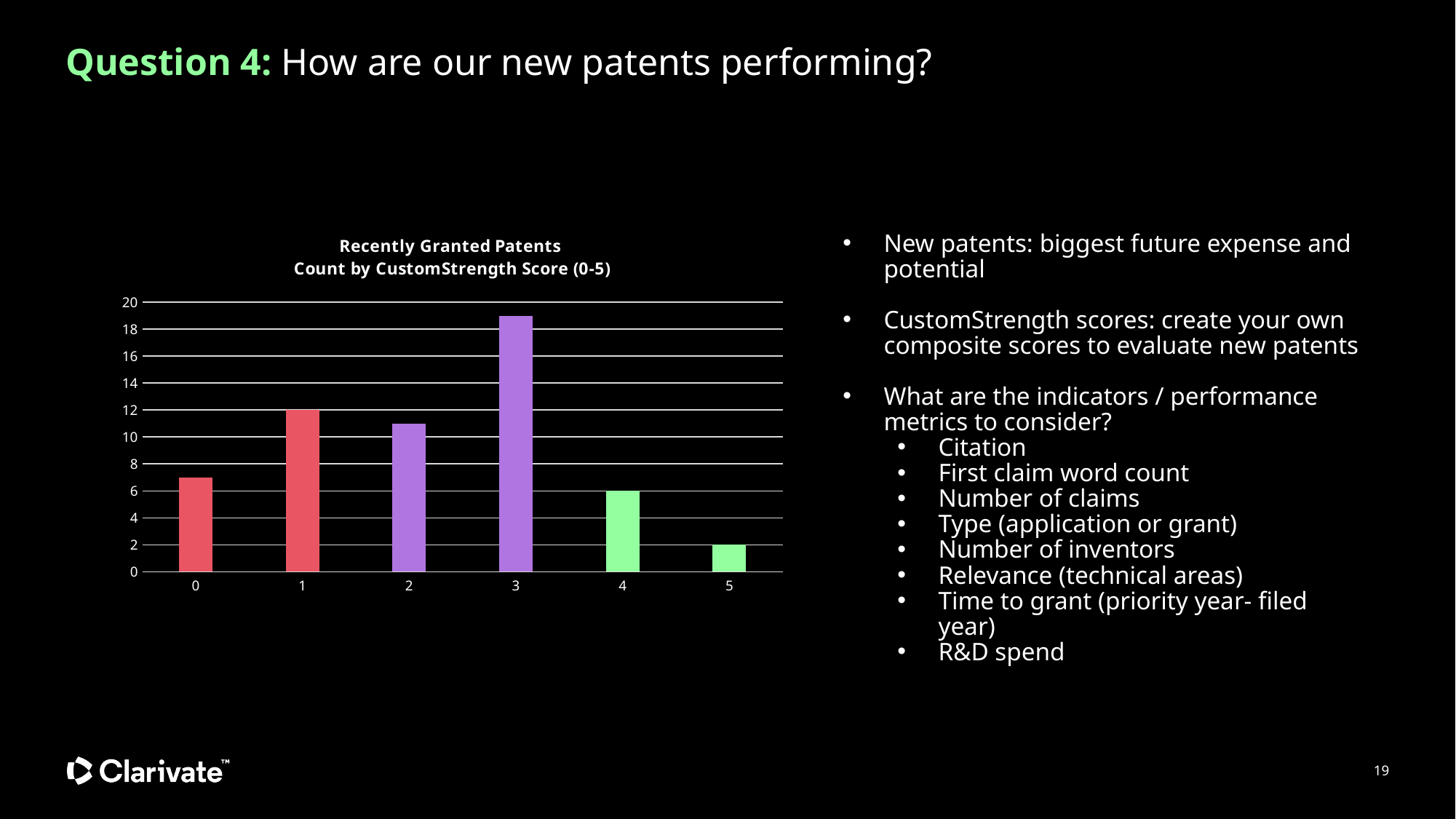
What is the title of the chart? Recently Granted Patents Count by CustomStrength Score (0-5) What is the count of patents with a CustomStrength score of 5? 2 How many CustomStrength score categories are shown on the x axis? 6 Is the count for CustomStrength score 0 greater or less than 8? less What type of chart is shown on the slide? bar chart Which CustomStrength score has the highest count of patents? 3 Is the count for CustomStrength score 3 greater or less than 18? greater What is the count of patents with a CustomStrength score of 1? 12 What is the count of patents with a CustomStrength score of 4? 6 Which has a higher count of patents, CustomStrength score 2 or score 4? 2 What is the difference between the counts for CustomStrength scores 1 and 4? 6 Which CustomStrength score has the lowest count of patents? 5